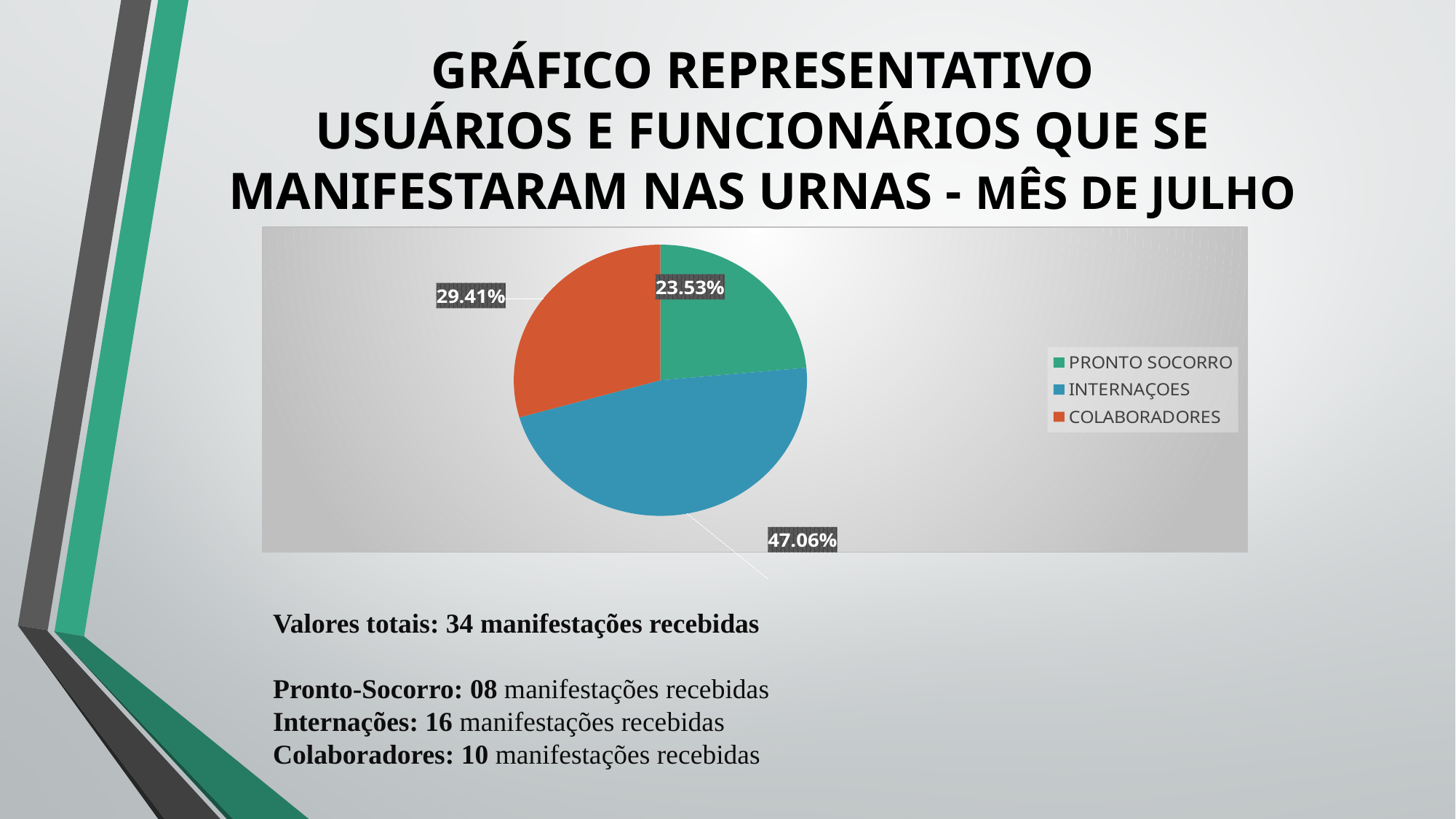
Which slice is larger in the pie chart, COLABORADORES or PRONTO SOCORRO? COLABORADORES Which category has the smallest slice in the pie chart? PRONTO SOCORRO What percentage does the pie chart show for COLABORADORES? 29.41% Which legend entry is shown in orange in the pie chart? COLABORADORES What colour is the INTERNAÇOES slice in the pie chart? blue How many slices does the pie chart have? 3 What kind of chart is shown on the slide? pie chart What percentage does the pie chart show for INTERNAÇOES? 47.06% How many entries does the legend of the pie chart list? 3 What percentage does the pie chart show for PRONTO SOCORRO? 23.53% What is the difference in percentage points between the INTERNAÇOES slice and the COLABORADORES slice? 17.65 Which category has the largest slice in the pie chart? INTERNAÇOES